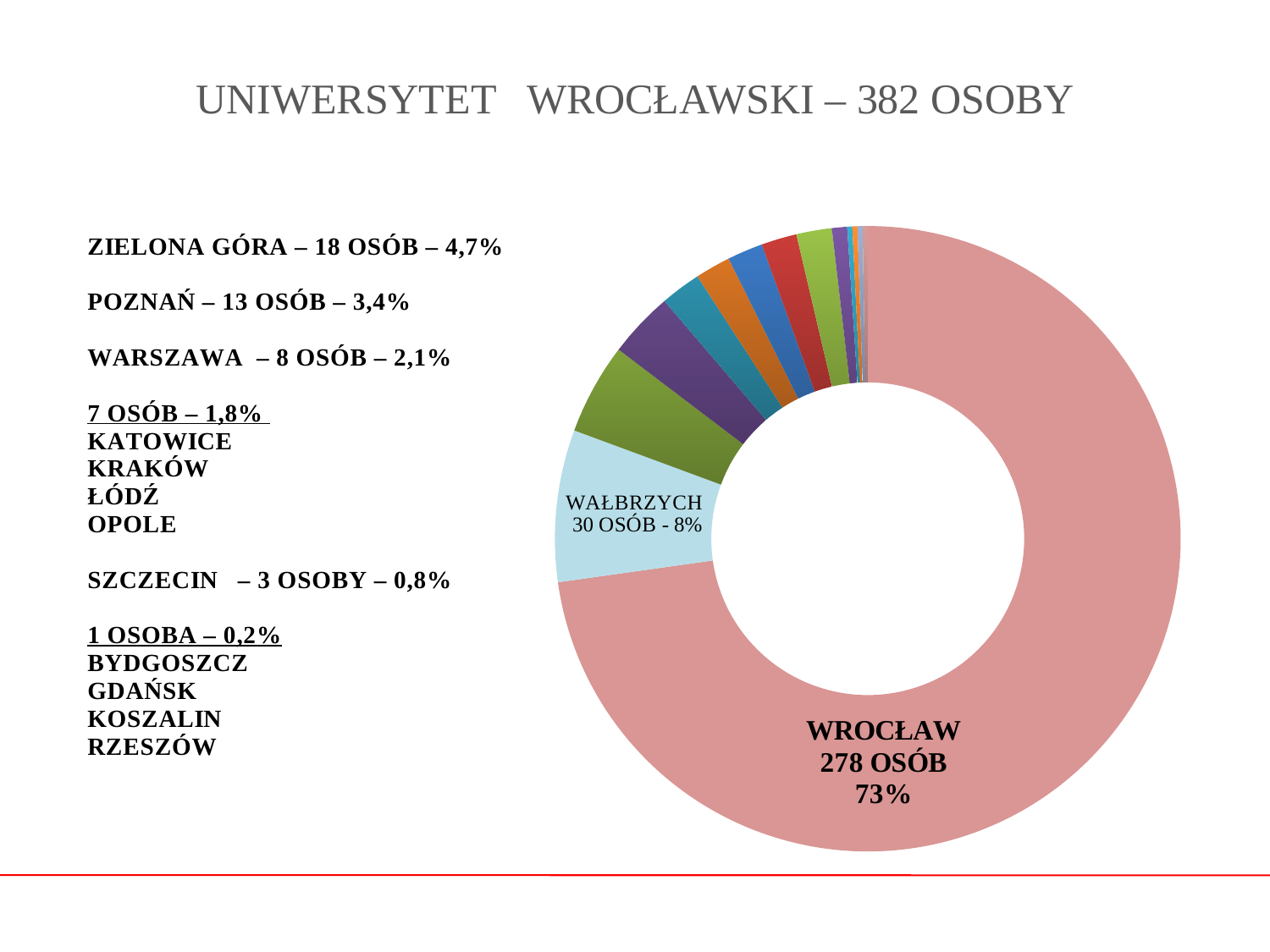
What percentage share of the doughnut chart does Wrocław have? 73% What is the title of the slide? UNIWERSYTET WROCŁAWSKI – 382 OSOBY According to the text on the slide, how many people and what percentage does Zielona Góra account for? 18 osób – 4,7% According to the text on the slide, what percentage does Szczecin account for? 0,8% Which slice is larger, Wrocław or Wałbrzych? Wrocław Which city has the largest slice in the chart? Wrocław What percentage share does the Wałbrzych slice have? 8% What kind of chart is shown on the slide? Pie (doughnut) chart What is the difference in number of people between the Wrocław and Wałbrzych slices? 248 How many people does the Wrocław slice of the doughnut chart represent? 278 osób How many people does the Wałbrzych slice represent? 30 osób According to the slide title, how many people in total does the chart represent? 382 osoby